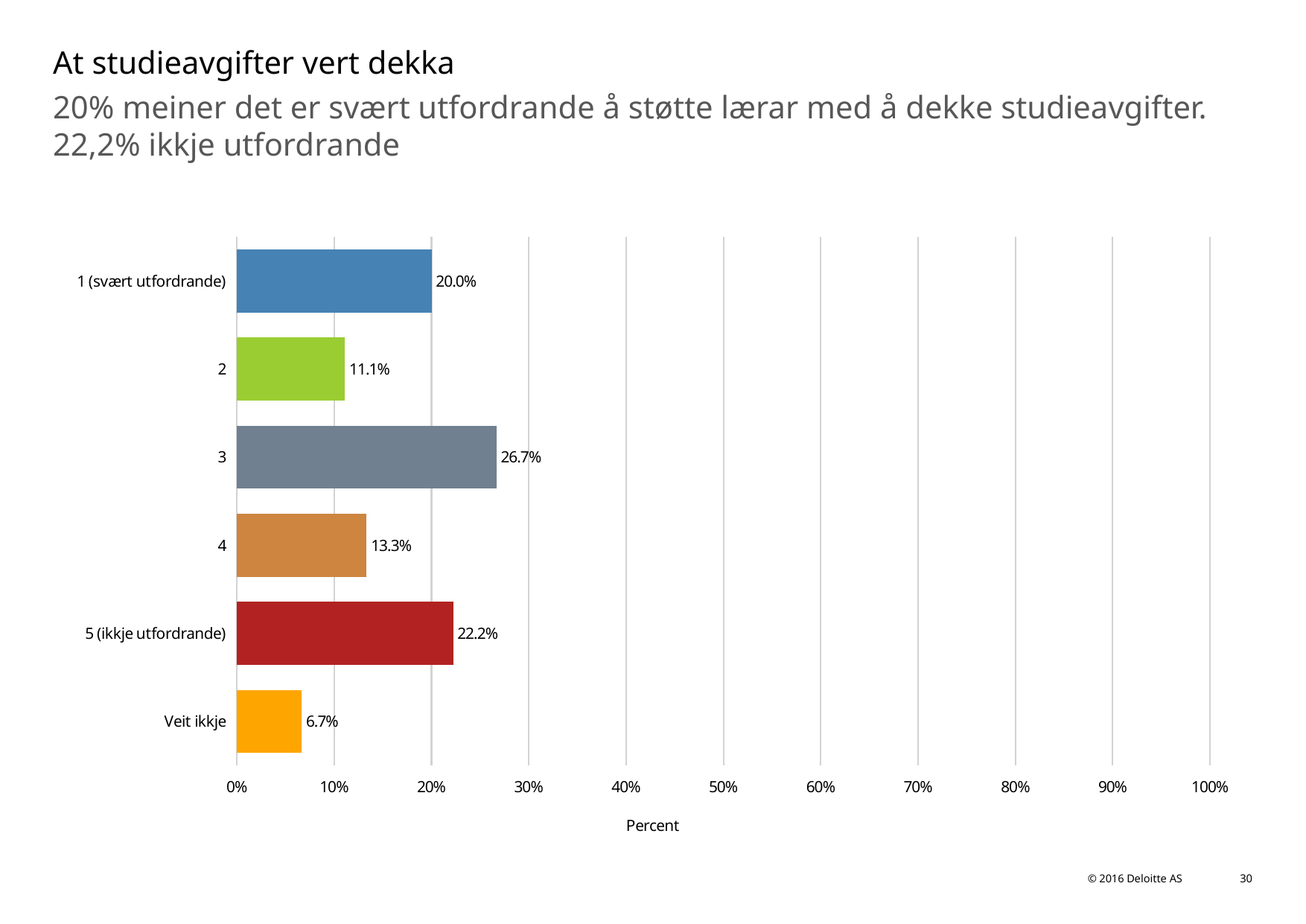
Which category has the highest value? 3 What is the difference between the values for "3" and "2"? 15.6% Is the value for "5 (ikkje utfordrande)" greater or less than 30%? less What colour is the bar for "Veit ikkje"? orange What kind of chart is shown on the slide? bar chart What is the value for the category "3"? 26.7% How many categories are shown in the chart? 6 Which is larger, the value for "1 (svært utfordrande)" or the value for "4"? 1 (svært utfordrande) What is the value for "Veit ikkje"? 6.7% What is the label of the horizontal axis? Percent Which category has the lowest value? Veit ikkje What is the value for "5 (ikkje utfordrande)"? 22.2%